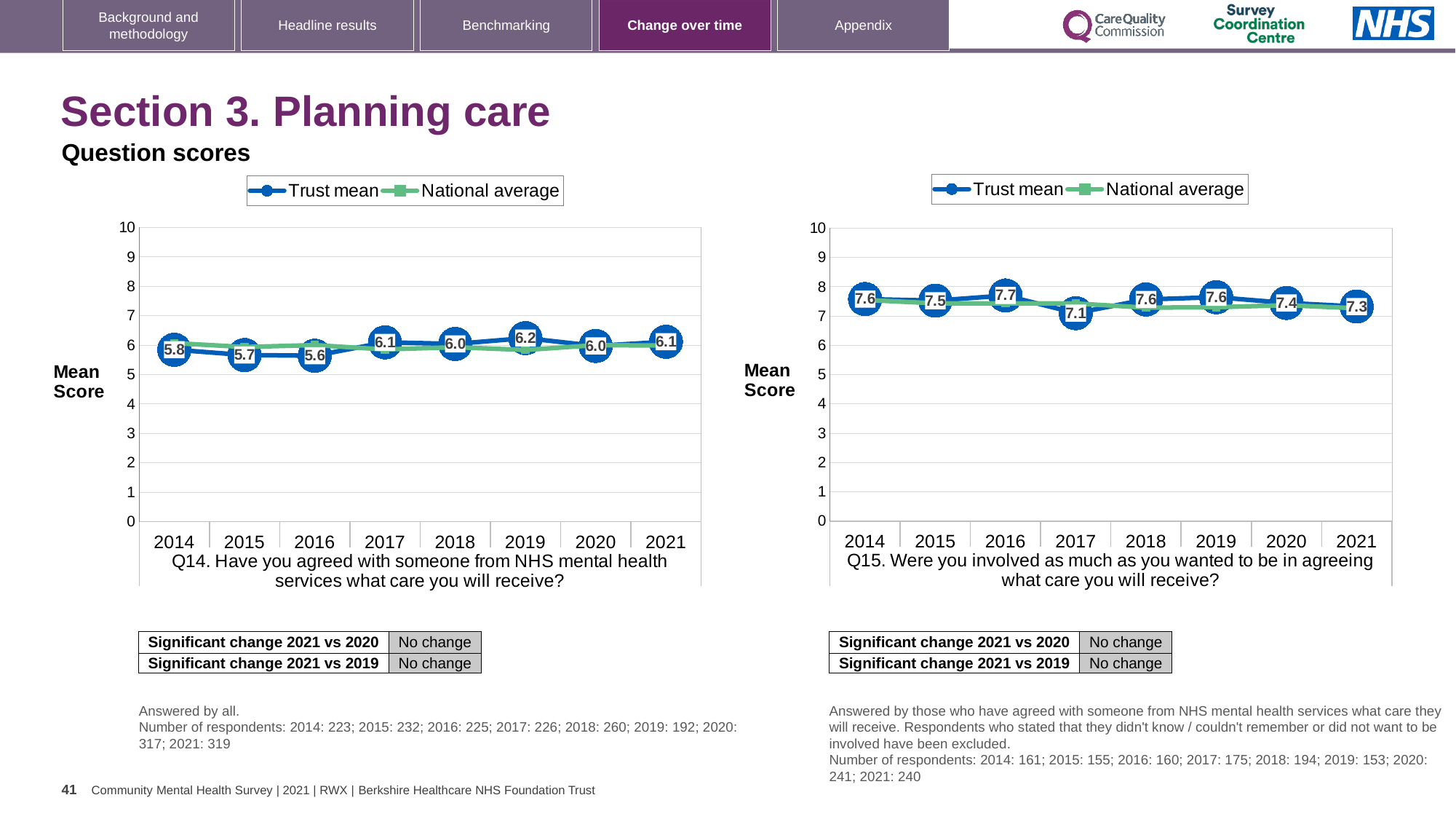
In the Q14 chart on the left, what is the difference between the Trust mean scores for 2019 and 2016? 0.6 How many series does the legend of the Q14 chart on the left list? 2 What type of chart is the Q14 chart on the left? Line chart In the Q14 chart on the left, what is the Trust mean score for 2016? 5.6 In the Q15 chart on the right, which year has the lowest Trust mean score? 2017 In the Q15 chart on the right, which year has the highest Trust mean score? 2016 In the Q14 chart on the left, which year has the highest Trust mean score? 2019 In the Q14 chart on the left, what is the Trust mean score for 2021? 6.1 In the Q15 chart on the right, what is the Trust mean score for 2017? 7.1 In the Q14 chart on the left, which year has the lowest Trust mean score? 2016 In the Q15 chart on the right, is the Trust mean score for 2021 larger or smaller than for 2014? smaller How many years are plotted on the x axis of the Q15 chart on the right? 8